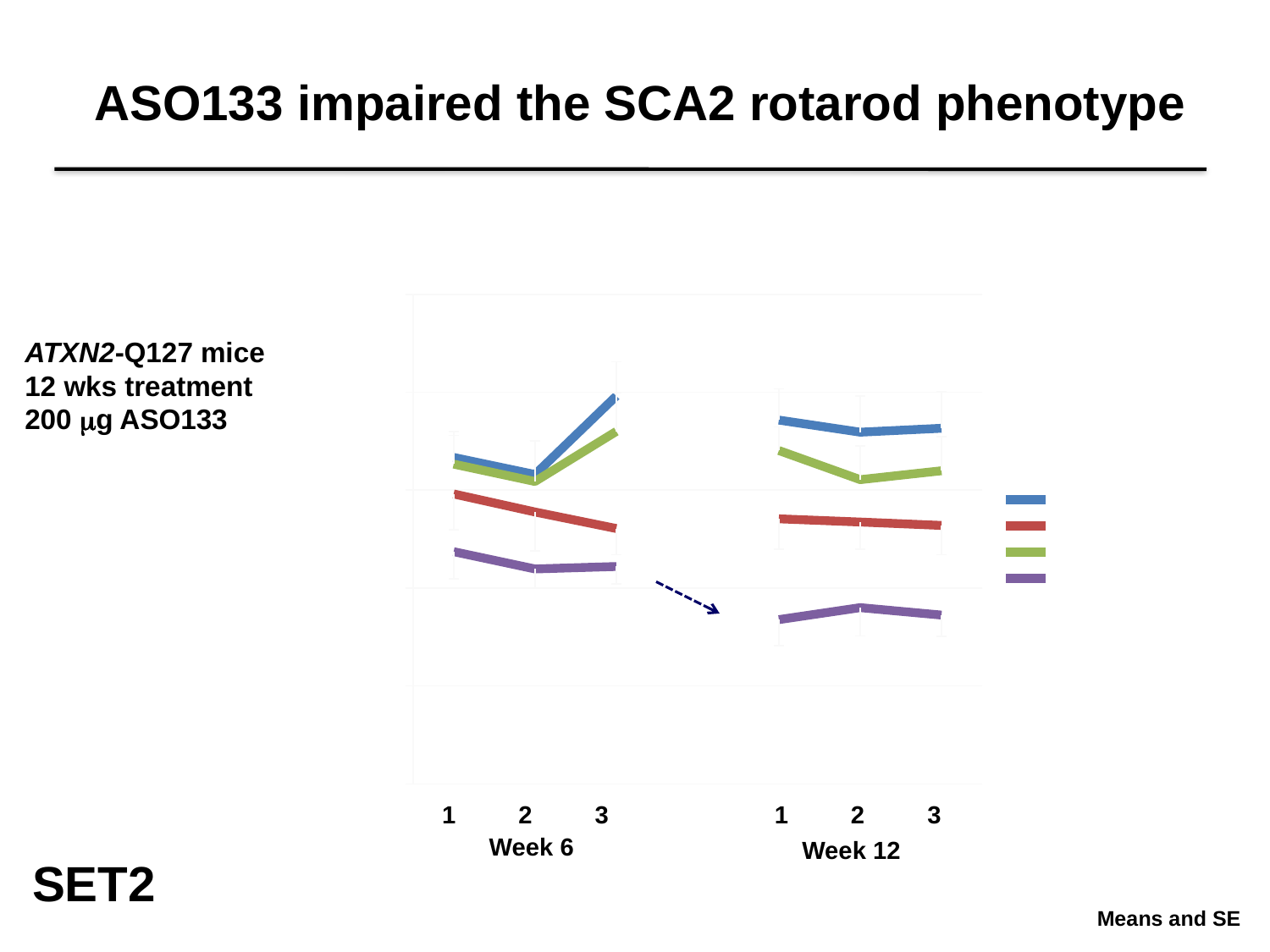
What is the title of the slide containing the chart? ASO133 impaired the SCA2 rotarod phenotype Which coloured line is lowest at Week 12? purple What are the two group labels on the x axis? Week 6 and Week 12 How many trial points are shown under Week 6? 3 Which coloured line is highest at Week 12? blue Does the red line rise or fall from trial 1 to trial 3 in Week 6? fall Does the blue line rise or fall from trial 2 to trial 3 in Week 6? rise What kind of chart is shown on the slide? line chart How many series does the legend list? 4 At trial 1 of Week 12, is the blue line or the purple line higher? blue How many x-axis points are plotted in total across Week 6 and Week 12? 6 At trial 3 of Week 6, is the green line or the red line higher? green